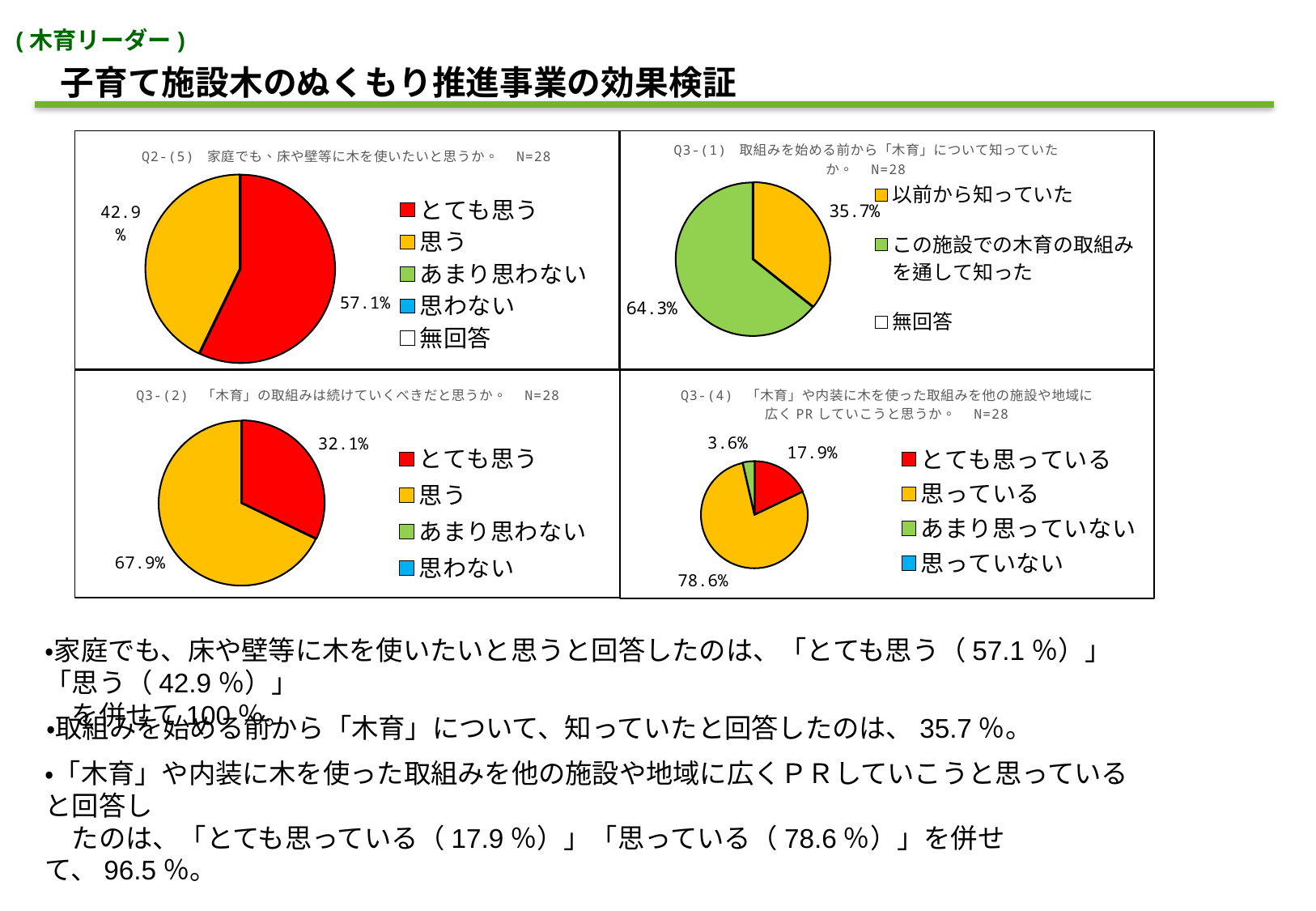
What type of chart is used for Q3-(1) in the top-right? Pie chart In the top-right chart (Q3-(1)), which response has the largest share? この施設での木育の取組みを通して知った In the bottom-left chart (Q3-(2)), what is the difference between the 「思う」 and 「とても思う」 shares? 35.8% What is the N value shown in the title of the bottom-right chart (Q3-(4))? N=28 In the top-left chart (Q2-(5)), what percentage of respondents answered 「とても思う」? 57.1% In the bottom-right chart (Q3-(4)), what percentage answered 「あまり思っていない」? 3.6% In the top-left chart (Q2-(5)), what percentage of respondents answered 「思う」? 42.9% In the bottom-right chart (Q3-(4)), which is larger: 「とても思っている」 or 「思っている」? 思っている In the bottom-left chart (Q3-(2)), what percentage answered 「思う」? 67.9% In the top-right chart (Q3-(1)), what percentage answered 「以前から知っていた」? 35.7% How many entries does the legend of the top-left chart (Q2-(5)) list? 5